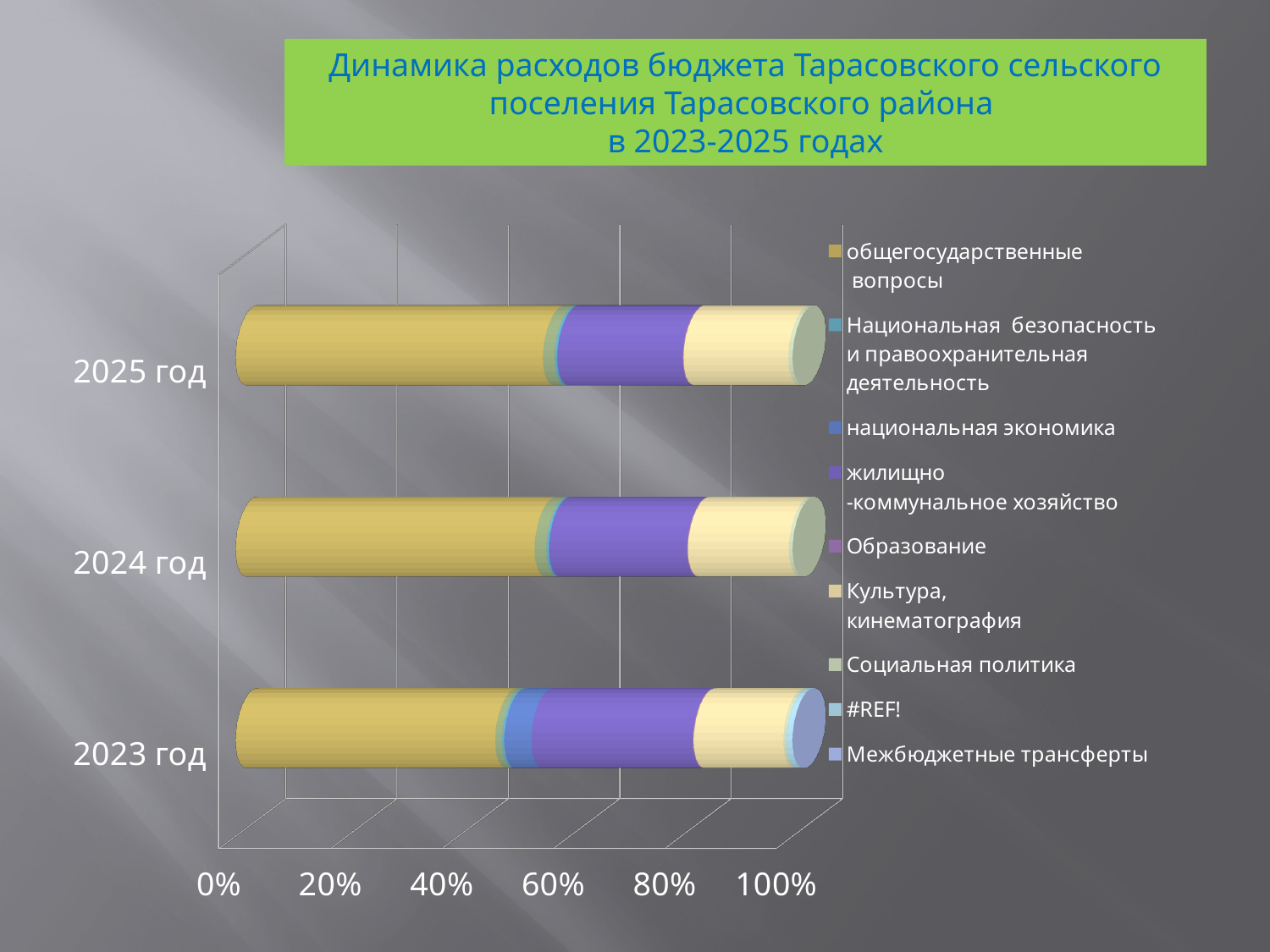
How many series does the legend list? 9 Is the share of общегосударственные вопросы in 2025 год greater or less than 40%? greater Is the share of общегосударственные вопросы in 2023 год greater or less than 40%? greater Is the share of общегосударственные вопросы in 2023 год greater or less than 60%? less How many years (categories) are plotted on the chart? 3 What kind of chart is shown on the slide? bar chart Which legend entry appears as an error text rather than a category name? #REF! Which year shows the largest share of национальная экономика? 2023 год What is the title of the chart on the slide? Динамика расходов бюджета Тарасовского сельского поселения Тарасовского района в 2023-2025 годах What is the highest value shown on the horizontal axis? 100% Which year has the larger share of общегосударственные вопросы, 2023 год or 2025 год? 2025 год